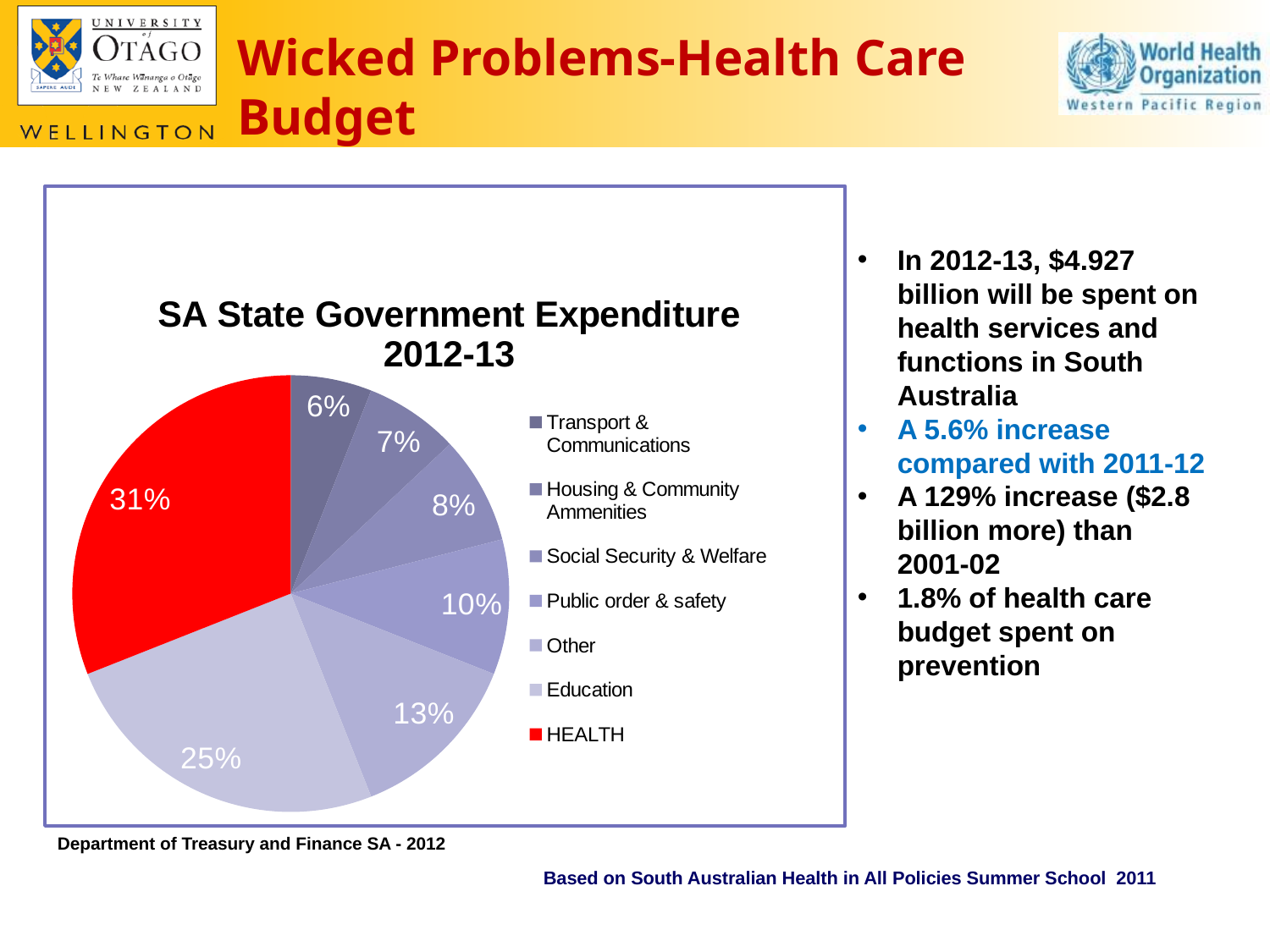
How many categories does the pie chart show? 7 How many percentage points larger is the HEALTH share than the Education share? 6% What percentage of expenditure is Public order & safety? 10% Which category has the largest share of the pie? HEALTH What is the title of the chart? SA State Government Expenditure 2012-13 What kind of chart is shown on the slide? Pie chart What share of the pie is Education? 25% What percentage of expenditure is Transport & Communications? 6% Which slice of the pie is coloured red? HEALTH Which is larger, the share for Other or the share for Social Security & Welfare? Other What share of SA State Government Expenditure 2012-13 goes to HEALTH? 31% Which category has the smallest share of the pie? Transport & Communications